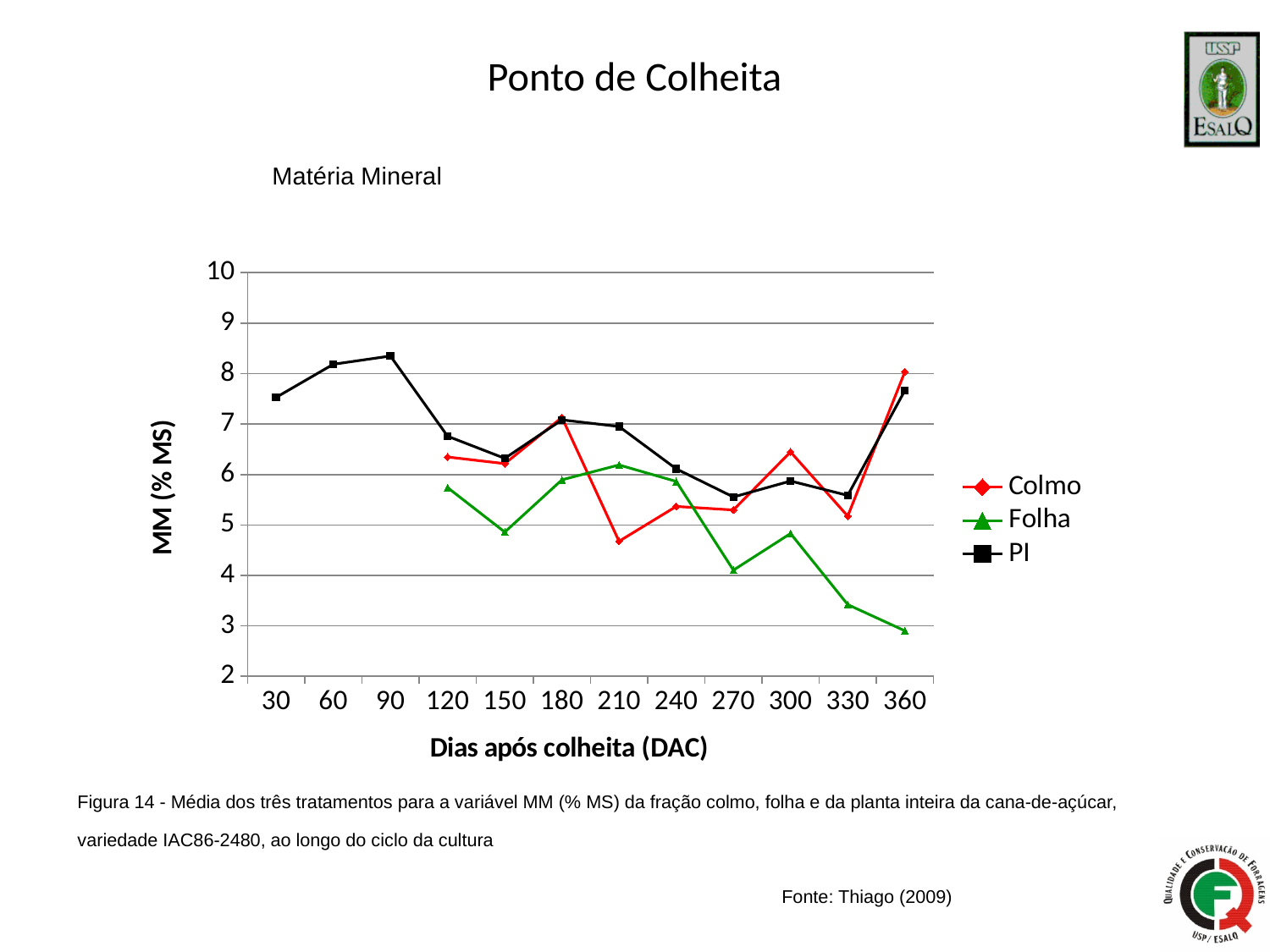
At which DAC does the Folha series reach its lowest value? 360 How many series does the legend list? 3 What kind of chart is shown on the slide? line chart Is the value for PI at 90 DAC greater or less than 8? greater At 270 DAC, which is larger: Colmo or Folha? Colmo What is the title of the y axis? MM (% MS) Is the value for Colmo at 210 DAC greater or less than 5? less Which series has the highest value at 360 DAC? Colmo Does the PI series rise or fall from 30 DAC to 90 DAC? rise How many DAC points are shown along the x axis? 12 Is the value for Folha at 330 DAC greater or less than 4? less